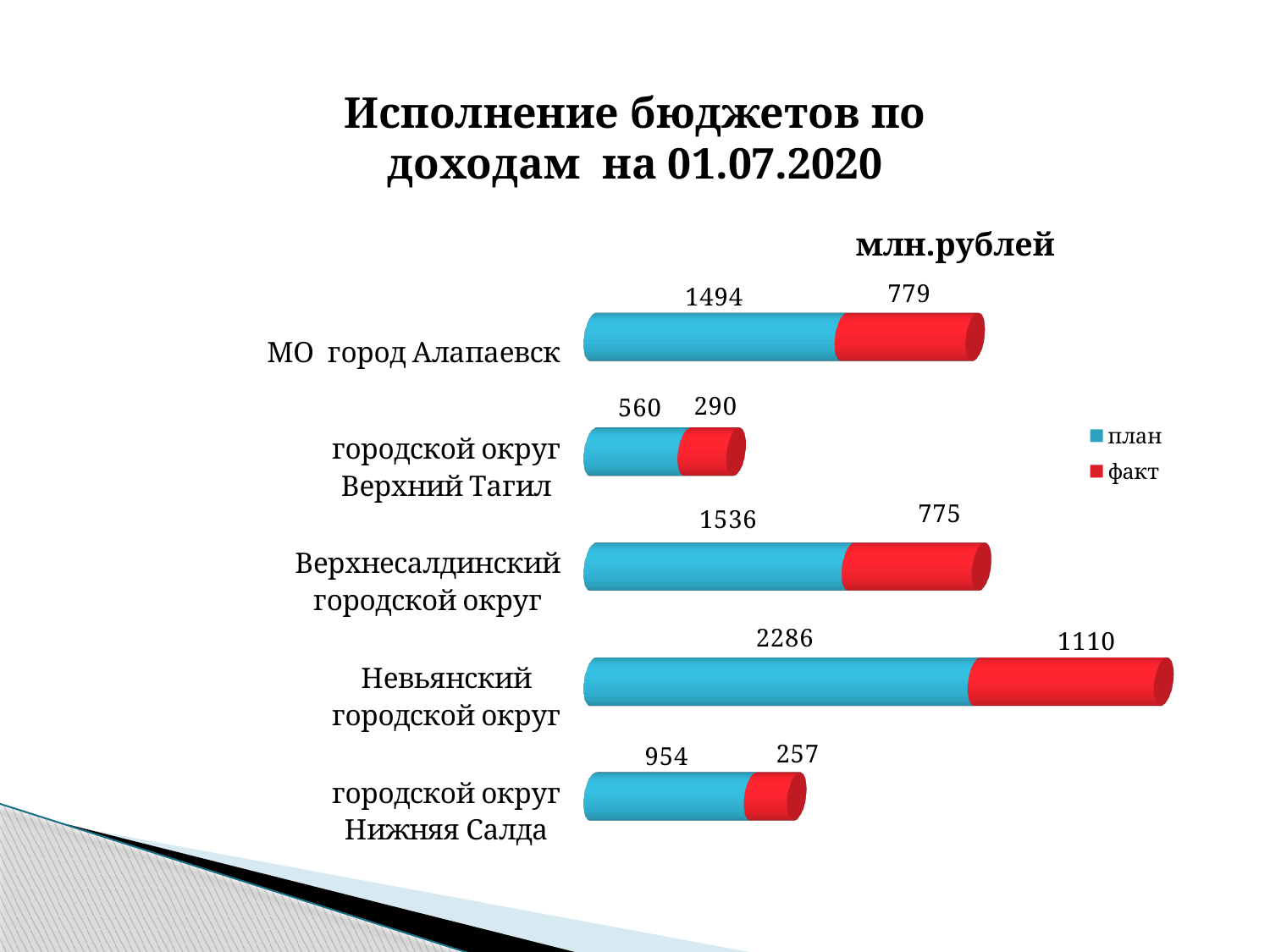
What is the difference between the план and факт values for городской округ Нижняя Салда? 697 Which is larger, the факт value for МО город Алапаевск or the факт value for Верхнесалдинский городской округ? МО город Алапаевск What is the total of the stacked bar for Верхнесалдинский городской округ? 2311 What kind of chart is shown on the slide? Stacked bar chart What unit is indicated above the chart? млн.рублей What is the факт value for городской округ Верхний Тагил? 290 How many series does the legend list? 2 Which category has the highest факт value? Невьянский городской округ Which category has the lowest план value? городской округ Верхний Тагил How many categories are shown in the chart? 5 What is the план value for Невьянский городской округ? 2286 What is the план value for МО город Алапаевск? 1494